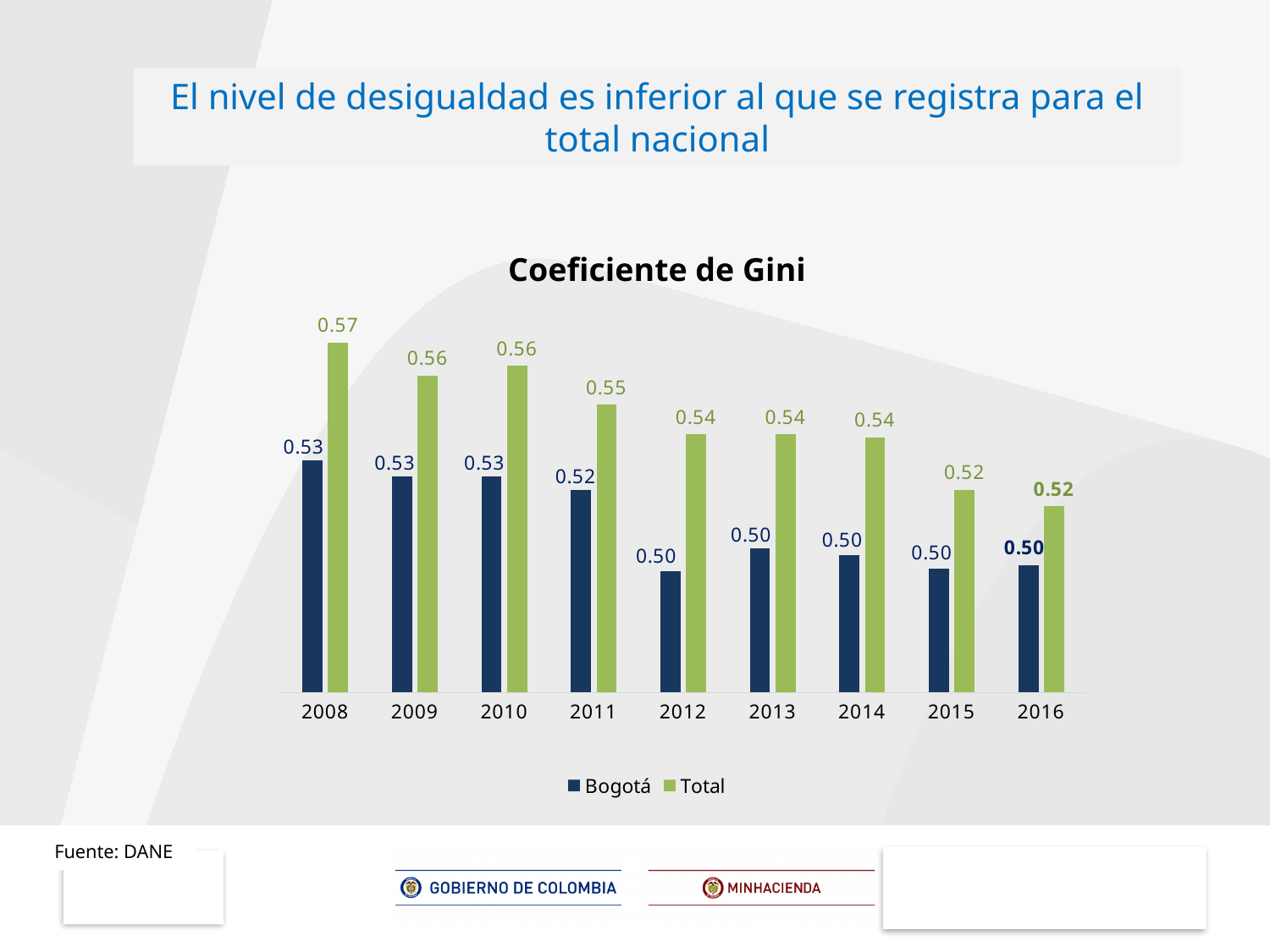
What is the value for Bogotá in 2016? 0.50 How many years are shown on the x axis of the chart? 9 In which year is the Total series highest? 2008 What is the difference between the Total value in 2008 and the Total value in 2016? 0.05 What is the value for Total in 2015? 0.52 What kind of chart is shown on the slide? Bar chart How many series does the legend list? 2 What is the value for Total in 2008 in the Coeficiente de Gini chart? 0.57 What is the value for Bogotá in 2011? 0.52 Does the Total series rise or fall from 2008 to 2016? Fall Which is larger in 2012, the Bogotá value or the Total value? Total What is the difference between the Total and Bogotá values in 2008? 0.04